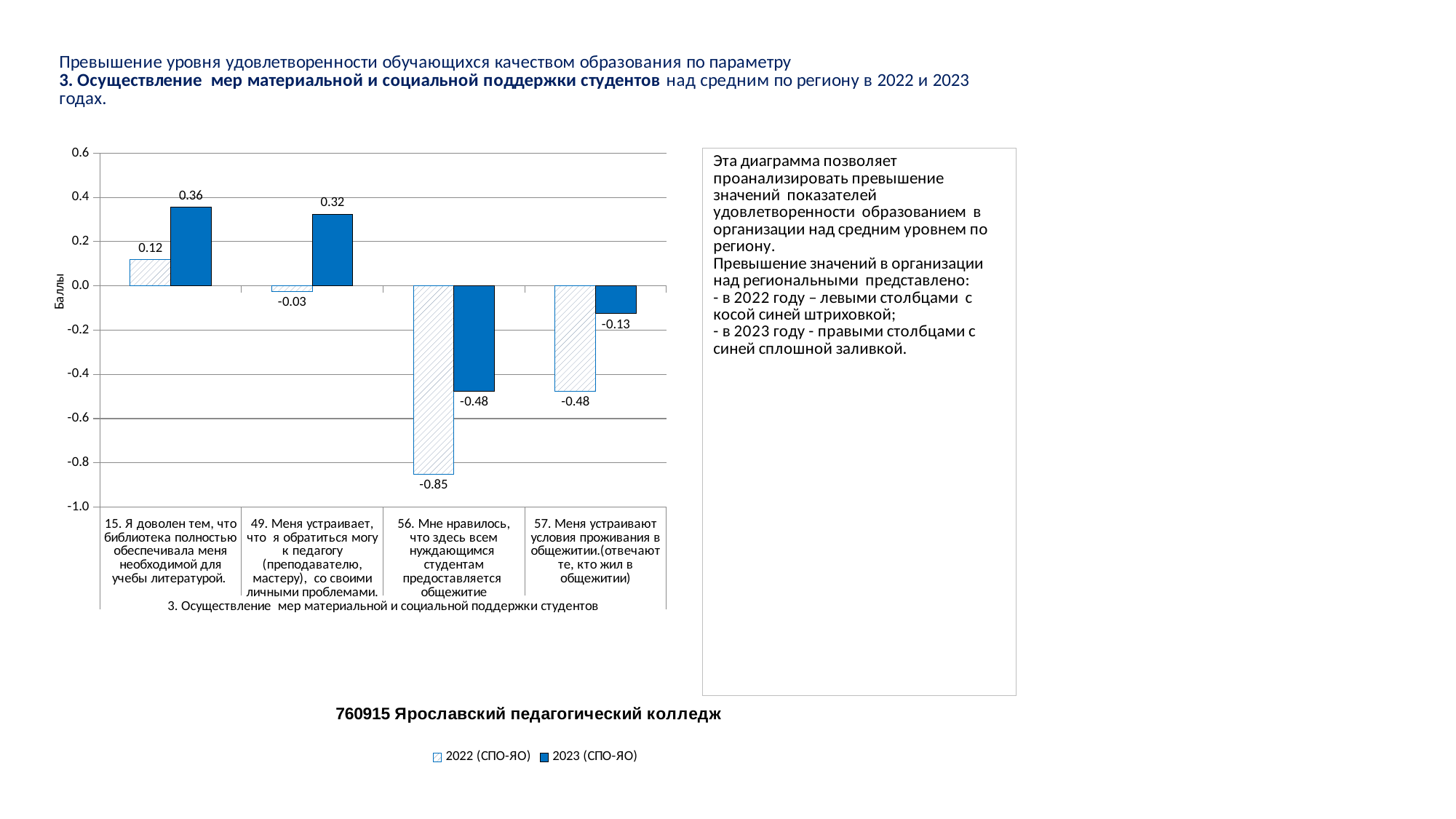
Which category has the lowest 2022 (СПО-ЯО) value? 56. Мне нравилось, что здесь всем нуждающимся студентам предоставляется общежитие What type of chart is shown on the slide? Bar chart What is the 2022 (СПО-ЯО) value for category 15 (library literature)? 0.12 What is the 2023 (СПО-ЯО) value for category 49 (can approach a teacher with personal problems)? 0.32 What is the difference between the 2023 and 2022 values for category 56? 0.37 Which category has the highest 2023 (СПО-ЯО) value? 15. Я доволен тем, что библиотека полностью обеспечивала меня необходимой для учебы литературой. What is the label of the vertical axis of the chart? Баллы What is the 2023 (СПО-ЯО) value for category 57 (dormitory living conditions)? -0.13 For category 49, which series has the larger value, 2022 (СПО-ЯО) or 2023 (СПО-ЯО)? 2023 (СПО-ЯО) What is the 2022 (СПО-ЯО) value for category 56 (dormitory provided to all students in need)? -0.85 How many series does the chart legend list? 2 How many categories are shown on the x axis of the chart? 4